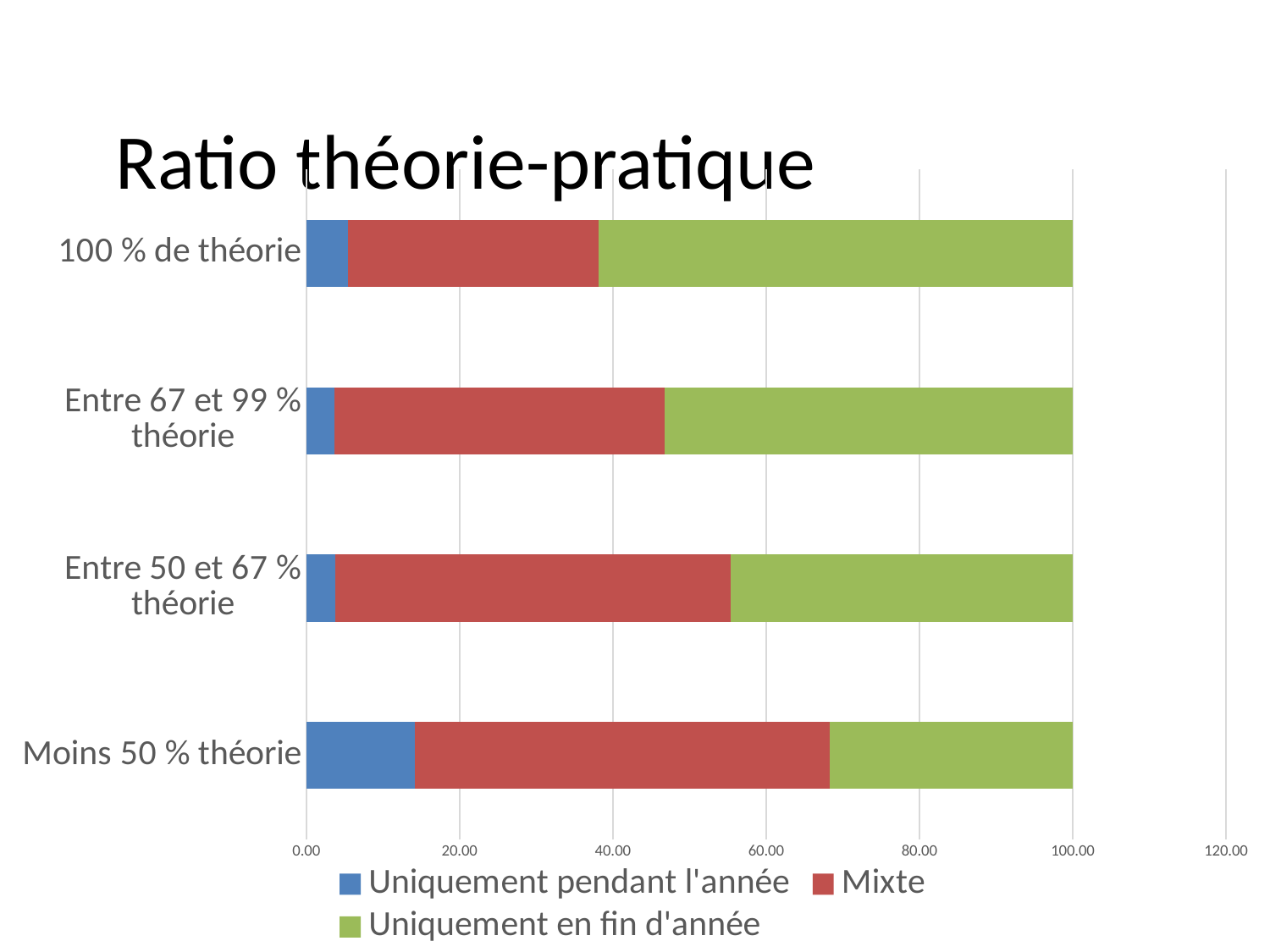
What is the total of the stacked bar for '100 % de théorie'? 100.00 What is the title of the chart? Ratio théorie-pratique Which category has the largest 'Uniquement en fin d'année' segment? 100 % de théorie Which has the larger 'Mixte' segment: '100 % de théorie' or 'Moins 50 % théorie'? Moins 50 % théorie What kind of chart is shown on the slide? Stacked bar chart Which category has the smallest 'Uniquement en fin d'année' segment? Moins 50 % théorie How many categories are plotted on the chart? 4 Is the 'Uniquement pendant l'année' value for 'Moins 50 % théorie' greater or less than 20.00? less Which series is shown in green in the legend? Uniquement en fin d'année Which category has the smallest 'Mixte' segment? 100 % de théorie How many series does the legend list? 3 Which category has the largest 'Uniquement pendant l'année' segment? Moins 50 % théorie